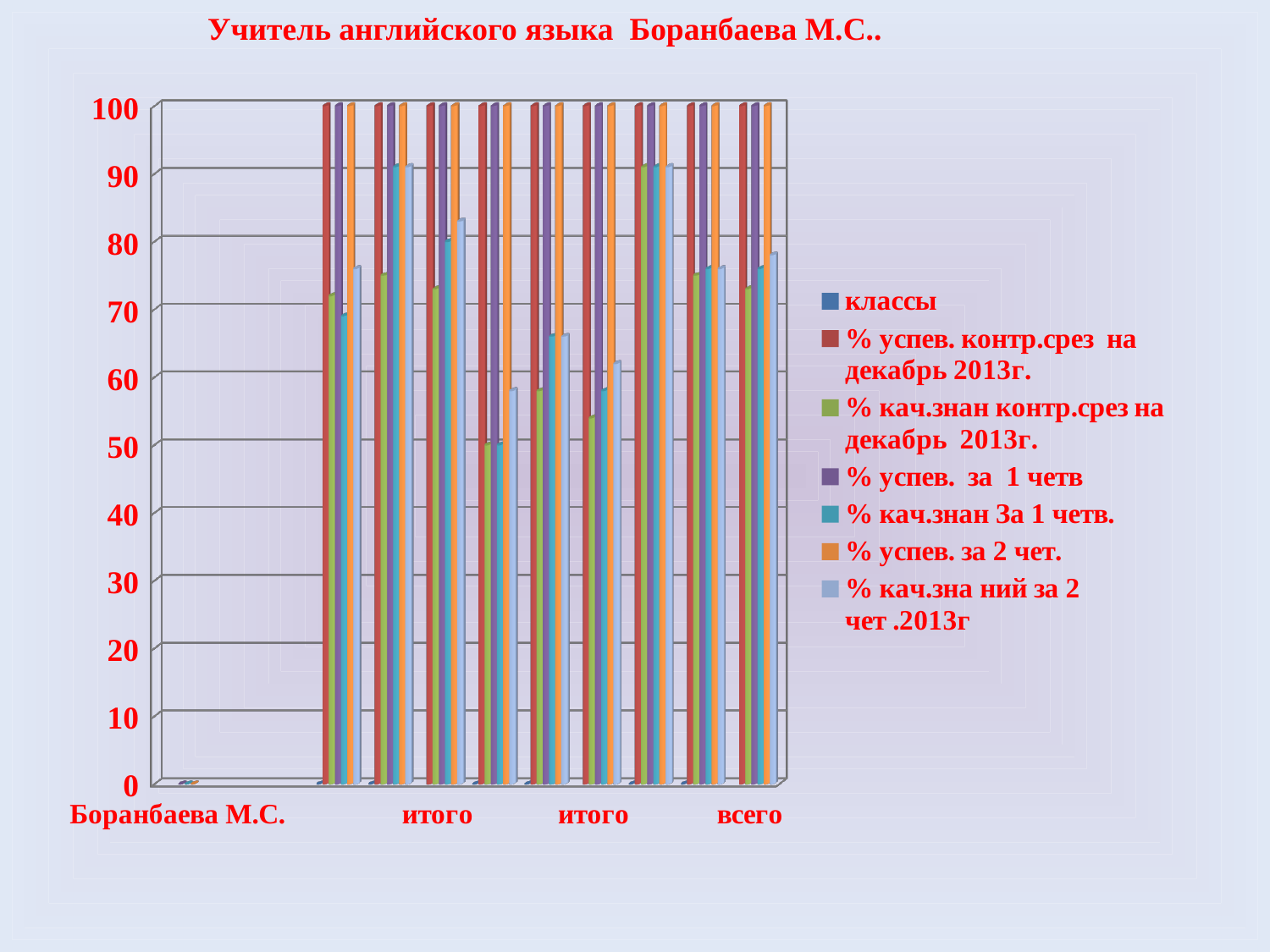
In the rightmost group of bars, which is taller: the bar for % успев. контр.срез на декабрь 2013г. or the bar for % кач.знан контр.срез на декабрь 2013г.? % успев. контр.срез на декабрь 2013г. What is the highest value shown on the vertical axis? 100 What kind of chart is shown on the slide? bar chart In the rightmost group of bars, is the value for % кач.зна ний за 2 чет .2013г greater or less than 70? greater How many series does the legend list? 7 What is the first entry in the chart legend? классы Are the bars for the category Боранбаева М.С. greater or less than 10? less In the rightmost group of bars, is the value for % успев. за 2 чет. greater or less than 90? greater